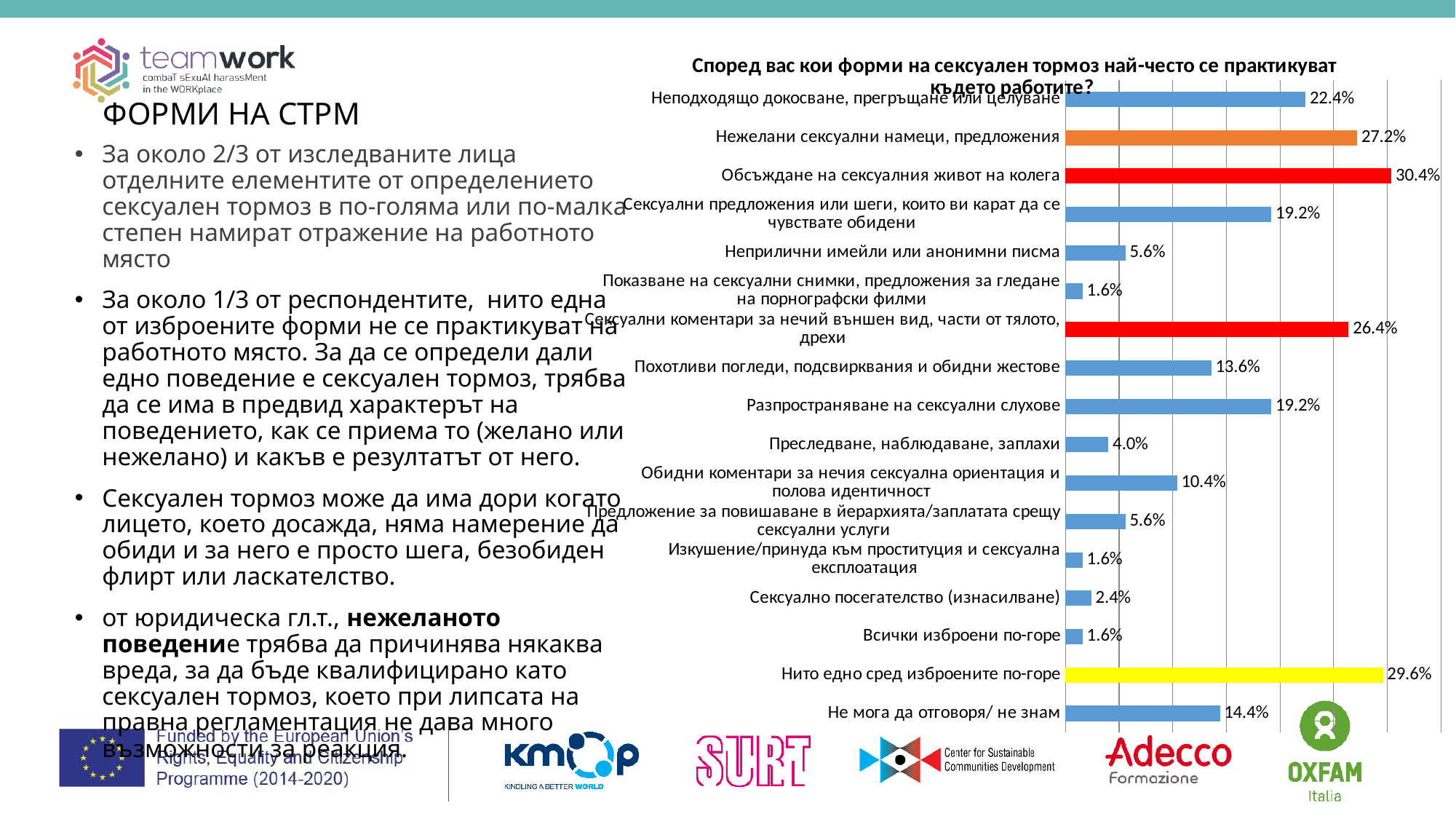
What type of chart is shown on the slide? bar chart How many categories are shown in the chart? 17 What is the difference between the values for "Обсъждане на сексуалния живот на колега" and "Нито едно сред изброените по-горе"? 0.8% What is the value for "Не мога да отговоря/ не знам"? 14.4% What colour is the bar for "Нито едно сред изброените по-горе"? yellow What is the value for "Обсъждане на сексуалния живот на колега"? 30.4% What is the value for "Сексуално посегателство (изнасилване)"? 2.4% What is the difference between the values for "Нежелани сексуални намеци, предложения" and "Неподходящо докосване, прегръщане или целуване"? 4.8% Which is larger: the value for "Сексуални коментари за нечий външен вид, части от тялото, дрехи" or the value for "Похотливи погледи, подсвирквания и обидни жестове"? Сексуални коментари за нечий външен вид, части от тялото, дрехи What is the value for "Нито едно сред изброените по-горе"? 29.6% What is the value for "Преследване, наблюдаване, заплахи"? 4.0% Which category has the highest value in the chart? Обсъждане на сексуалния живот на колега